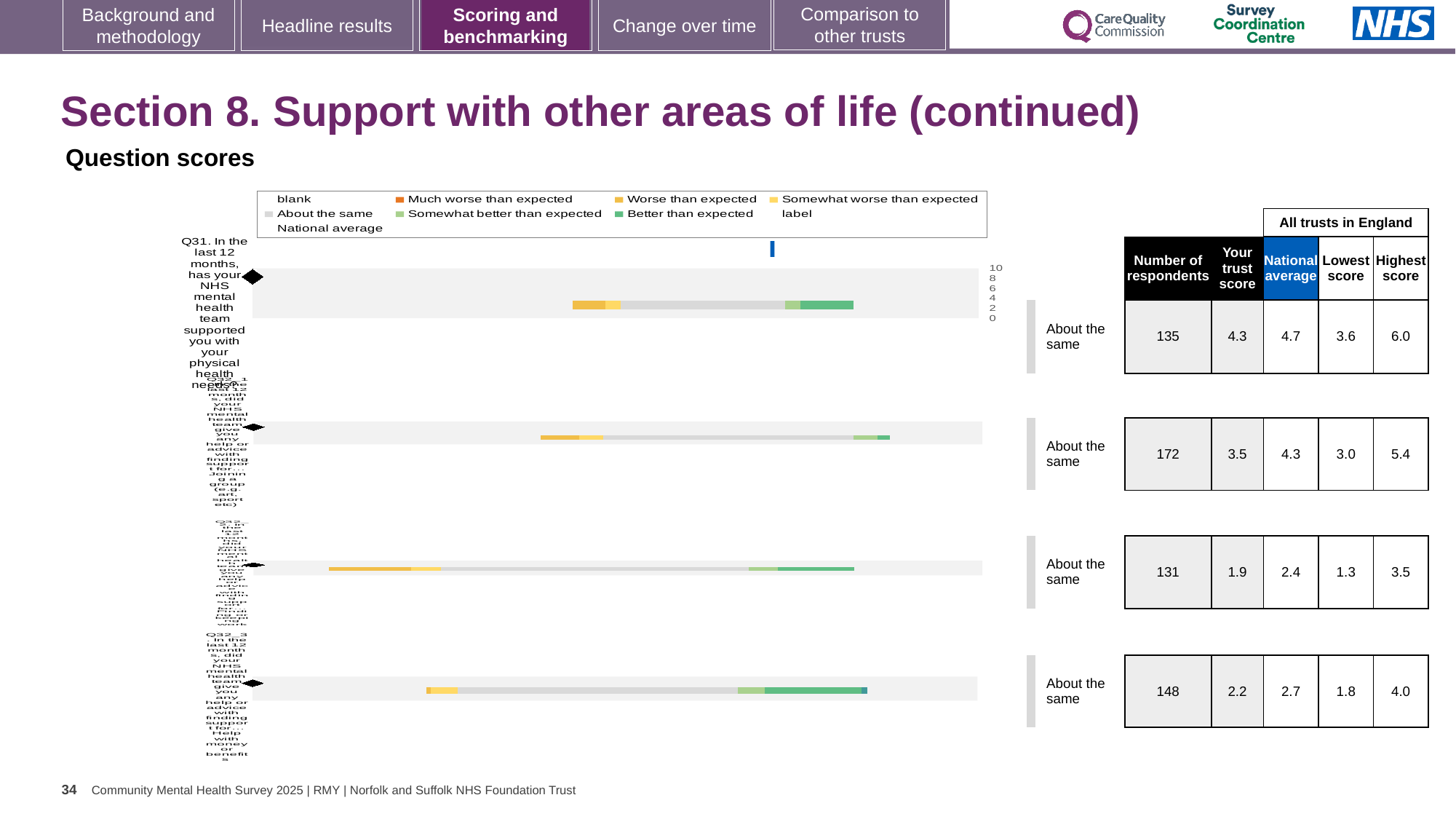
What is the lowest trust score shown in the table? 1.9 What kind of chart is shown on the slide? bar chart What is the maximum value shown on the chart's numeric axis? 10 For Q31, which is larger: the trust score or the national average? National average How many entries does the chart legend list? 9 What benchmark label is shown next to each of the four bars? About the same Which question (by position from the top) has the highest number of respondents, and what is that number? Second question, 172 What is the difference between the highest score (6.0) and the lowest score (3.6) for Q31? 2.4 What is the national average for Q31 (support with physical health needs)? 4.7 What is the trust score for Q31 (support with physical health needs)? 4.3 How many respondents answered Q31 (support with physical health needs)? 135 How many bars (questions) are plotted in the chart? 4